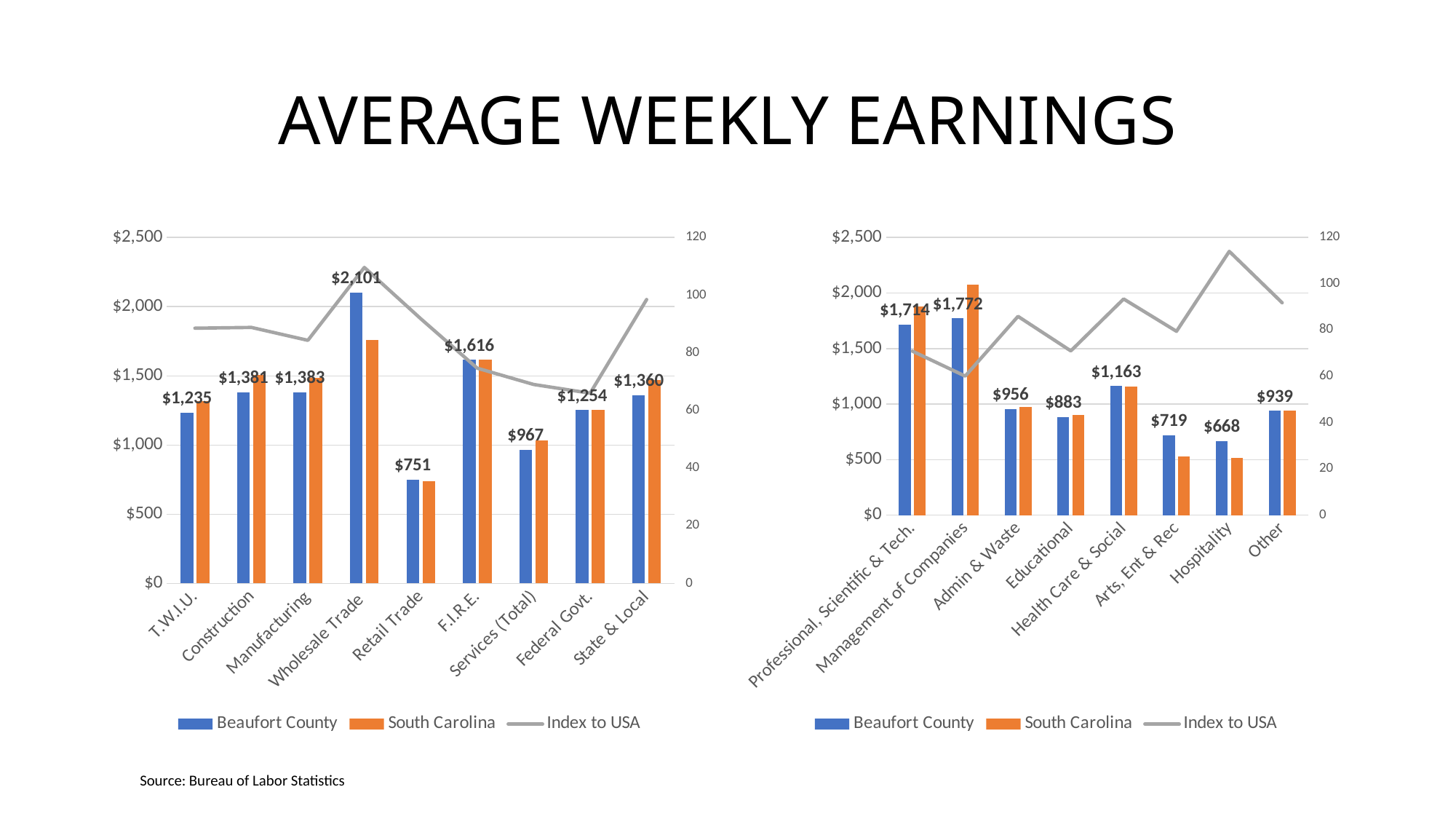
On the left chart, how much higher is the Beaufort County value for Wholesale Trade than for F.I.R.E.? $485 On the right chart, which category has the highest Beaufort County average weekly earnings? Management of Companies On the left chart, which category has the highest Beaufort County average weekly earnings? Wholesale Trade On the right chart, which category has the lowest Beaufort County average weekly earnings? Hospitality On the left chart, what is the Beaufort County average weekly earnings for Wholesale Trade? $2,101 On the right chart, what is the difference between the Beaufort County values for Health Care & Social and Educational? $280 On the left chart, which category has the lowest Beaufort County average weekly earnings? Retail Trade How many categories are shown on the left chart? 9 On the left chart, what is the Beaufort County value for Retail Trade? $751 How many series does the legend of the right chart list? 3 On the right chart, what is the Beaufort County value for Hospitality? $668 On the right chart, is the Beaufort County value larger for Admin & Waste or for Educational? Admin & Waste